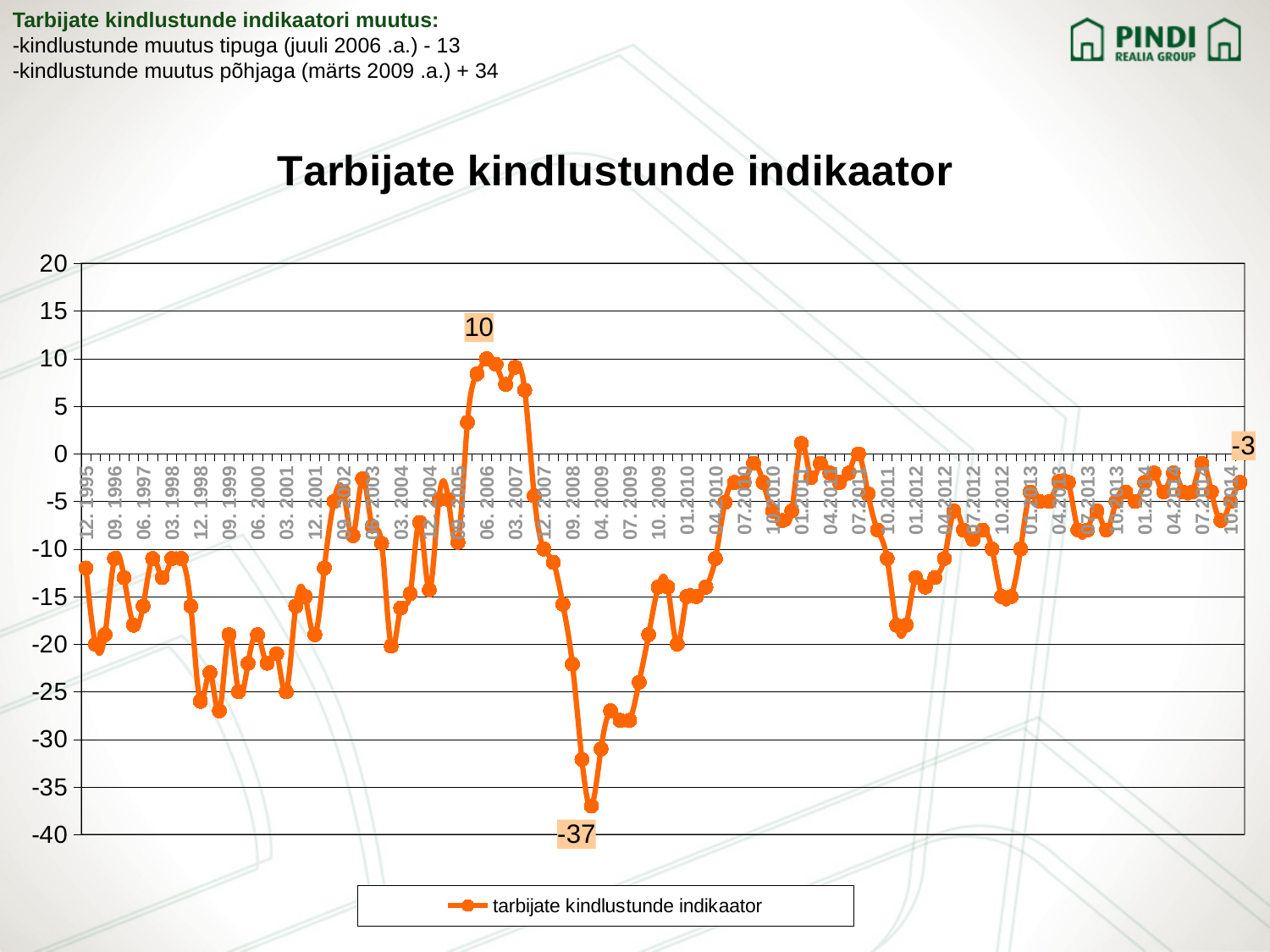
Which is larger, the value around 06. 2006 or the value around 04. 2009? 06. 2006 What is the value labeled at the last data point (10.2014)? -3 Do the values rise or fall between 06. 2006 and 04. 2009? fall Is the value around 12. 1998 greater or less than -20? less What is the highest value labeled on the chart? 10 What is the title of the chart? Tarbijate kindlustunde indikaator What is the difference between the last labeled value (-3) and the labeled trough value (-37)? 34 How many series does the legend list? 1 What kind of chart is shown on the slide? line chart Is the value around 03. 2007 greater or less than 5? greater What is the difference between the labeled peak value (10) and the labeled trough value (-37)? 47 What is the lowest value labeled on the chart? -37